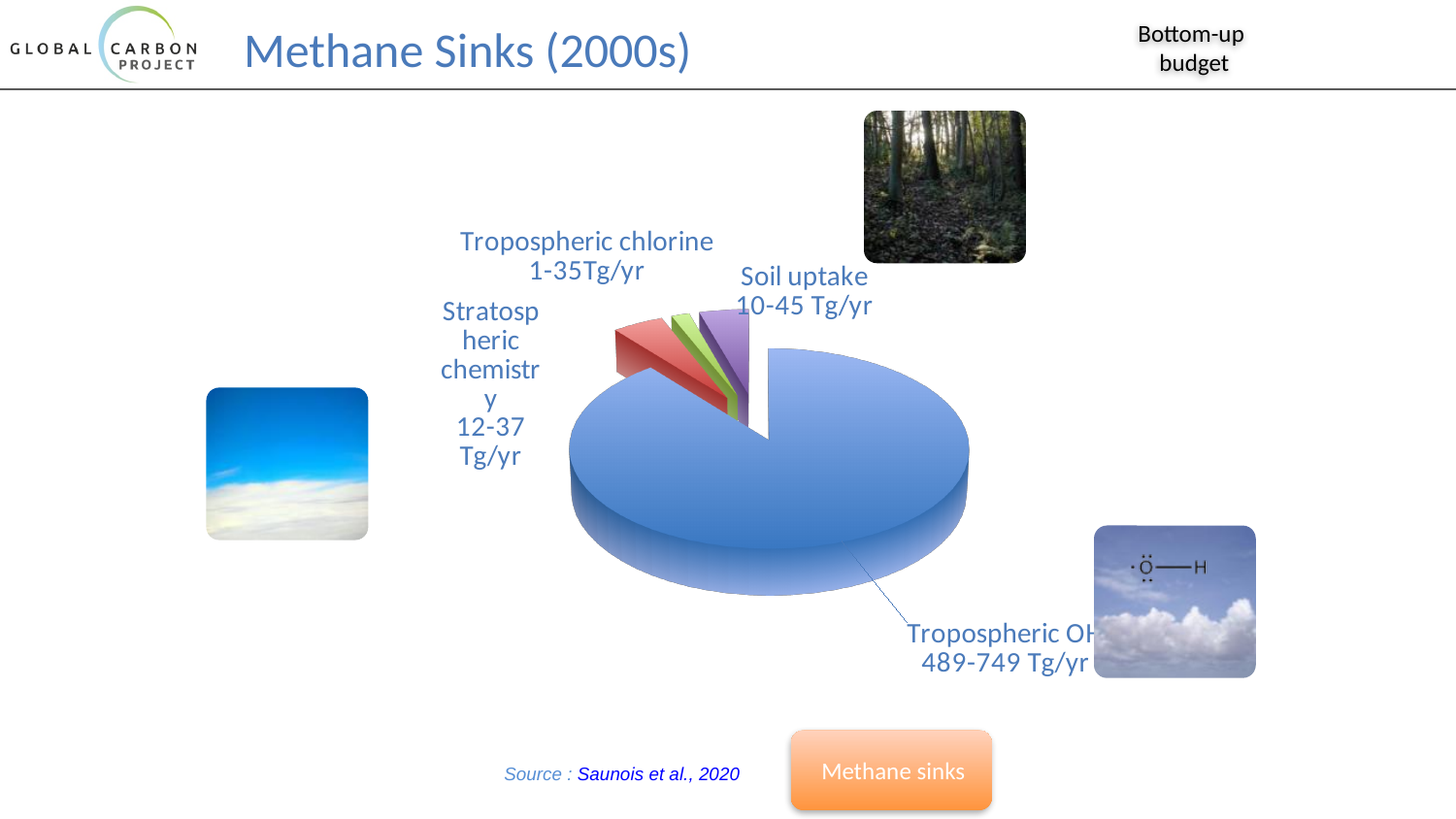
What is the title of the chart on the slide? Methane Sinks (2000s) Which slice is larger, Tropospheric OH or Stratospheric chemistry? Tropospheric OH What value range is labelled for Stratospheric chemistry? 12-37 Tg/yr Which methane sink has the largest slice of the pie? Tropospheric OH What value range is labelled for Tropospheric OH? 489-749 Tg/yr What value range is labelled for Soil uptake? 10-45 Tg/yr How many slices does the pie chart have? 4 What kind of chart is shown on the slide? pie chart What value range is labelled for Tropospheric chlorine? 1-35Tg/yr What colour is the Tropospheric OH slice of the pie? blue Which slice is larger, Stratospheric chemistry or Tropospheric chlorine? Stratospheric chemistry